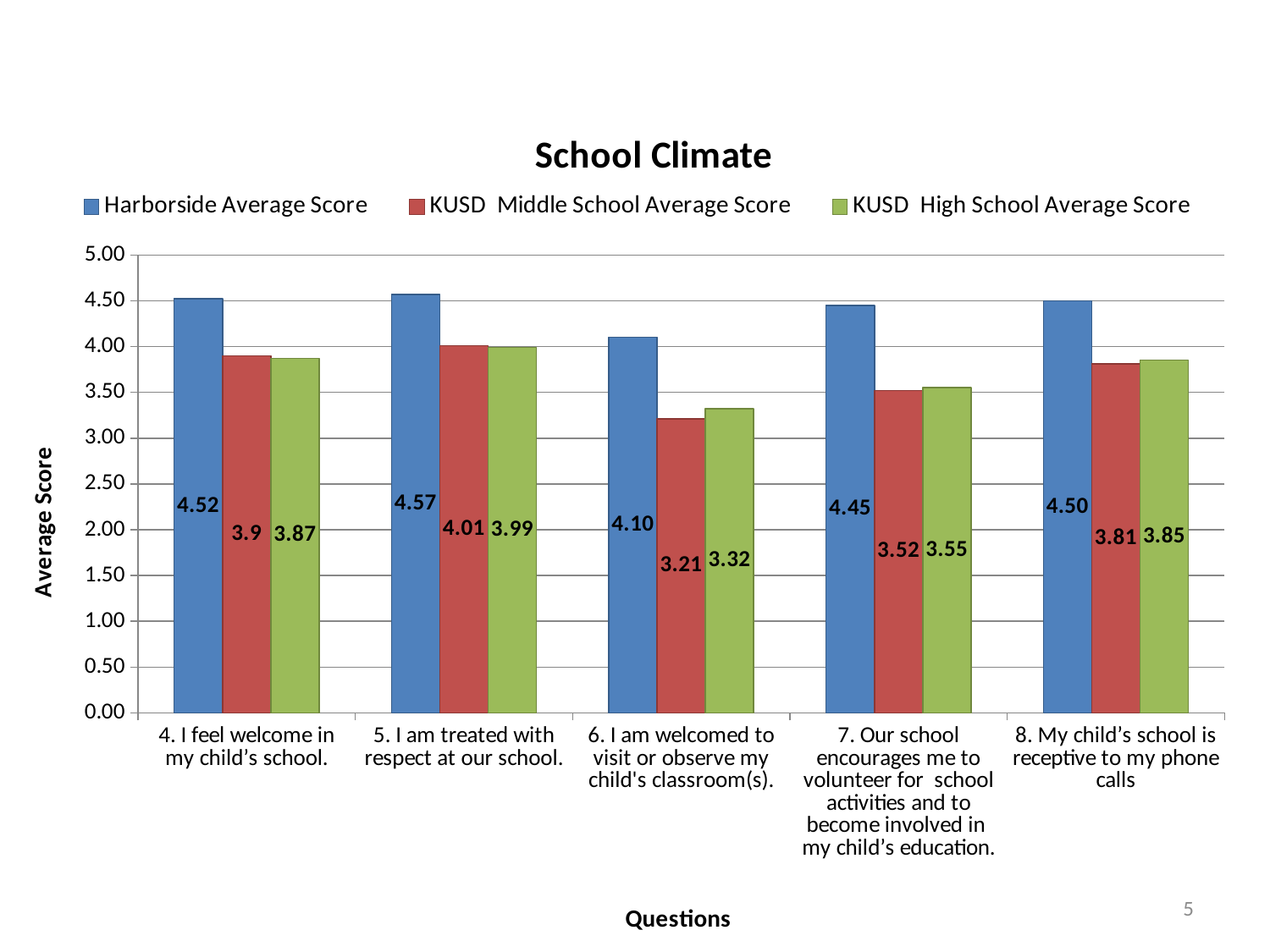
What is the difference between the Harborside Average Score and the KUSD Middle School Average Score for question 6? 0.89 For question 8, which is larger: the KUSD Middle School Average Score or the KUSD High School Average Score? KUSD High School Average Score Which question has the highest Harborside Average Score? 5. I am treated with respect at our school. Is the Harborside Average Score for question 7 greater or less than 4.00? greater What kind of chart is shown on the slide? Bar chart What is the Harborside Average Score for question 4, "I feel welcome in my child's school"? 4.52 How many questions (categories) are shown on the x axis? 5 What is the KUSD Middle School Average Score for question 6, "I am welcomed to visit or observe my child's classroom(s)"? 3.21 Which question has the lowest KUSD Middle School Average Score? 6. I am welcomed to visit or observe my child's classroom(s). How many series does the legend list? 3 What is the KUSD High School Average Score for question 7, about the school encouraging volunteering? 3.55 What is the title of the chart? School Climate